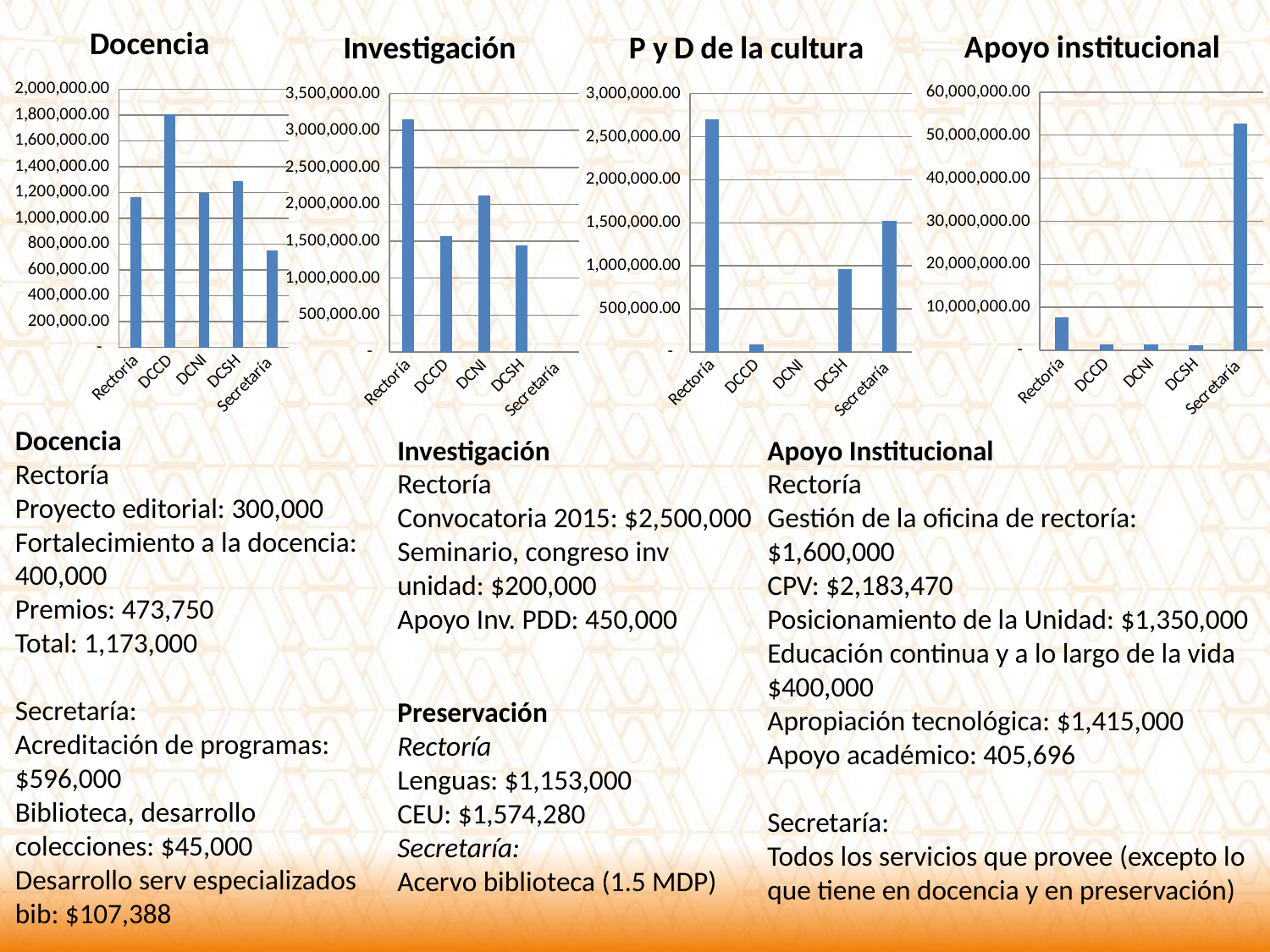
In the Docencia chart, is the value for DCCD greater or less than 1,600,000.00? greater In the P y D de la cultura chart, which category has the highest value? Rectoría In the Docencia chart, is the value for Secretaría greater or less than 1,000,000.00? less In the Investigación chart, which category has the highest value? Rectoría In the Docencia chart, which category has the lowest value? Secretaría In the Investigación chart, which is larger, the value for DCNI or the value for DCSH? DCNI In the Apoyo institucional chart, is the value for Rectoría greater or less than 10,000,000.00? less In the Docencia chart, which category has the highest value? DCCD How many bar charts are shown on the slide? 4